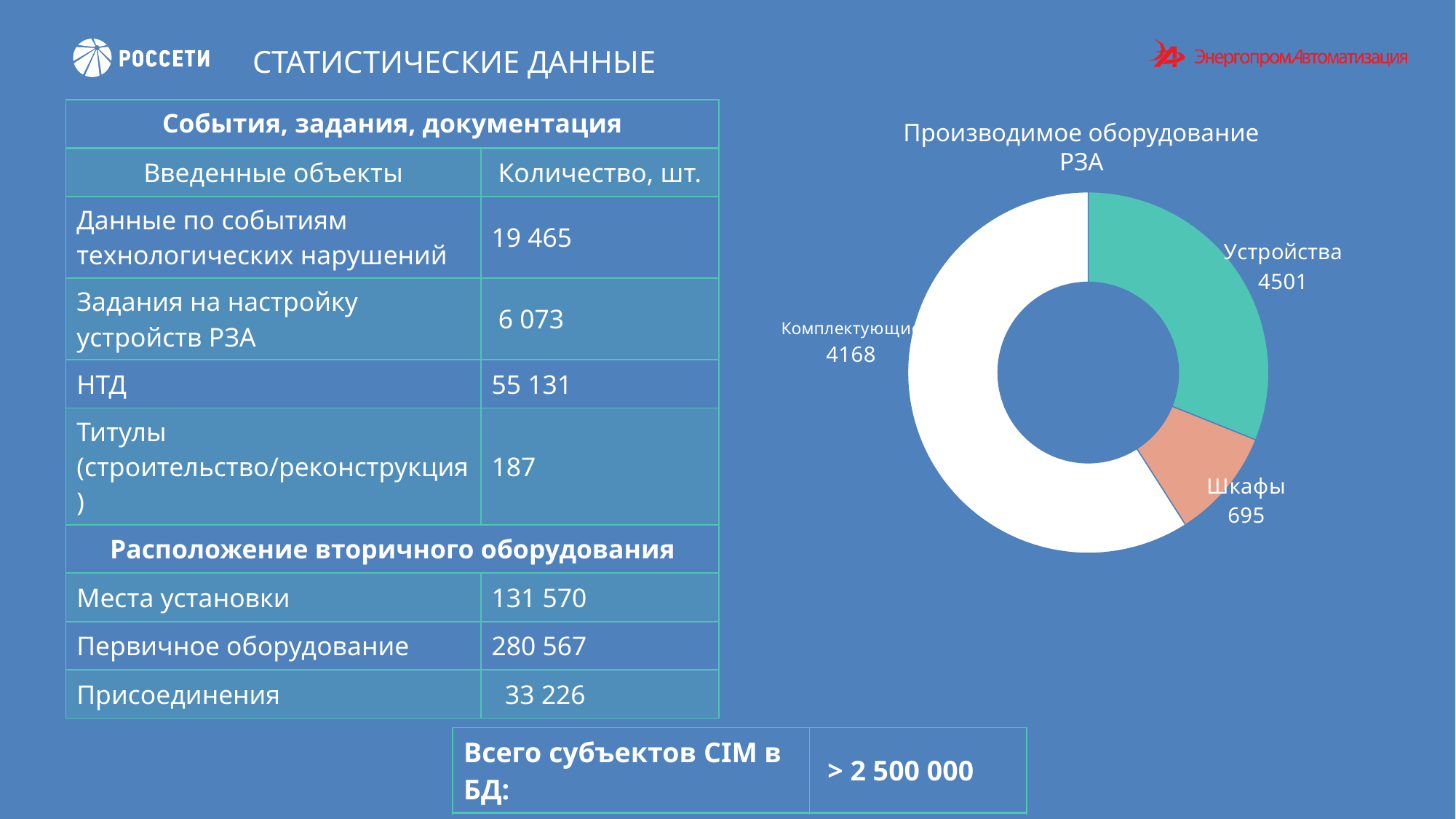
What is the value for Шкафы in the doughnut chart? 695 What is the total of all values shown in the doughnut chart? 9364 What is the difference between the values for Устройства and Шкафы in the doughnut chart? 3806 What is the value for Комплектующие in the doughnut chart? 4168 What is the value for Устройства in the doughnut chart? 4501 Which is larger in the doughnut chart, Комплектующие or Шкафы? Комплектующие Which category has the lowest value in the doughnut chart? Шкафы What is the difference between the values for Устройства and Комплектующие in the doughnut chart? 333 What kind of chart is shown on the slide? Doughnut chart What is the title of the chart on the slide? Производимое оборудование РЗА How many categories are shown in the doughnut chart? 3